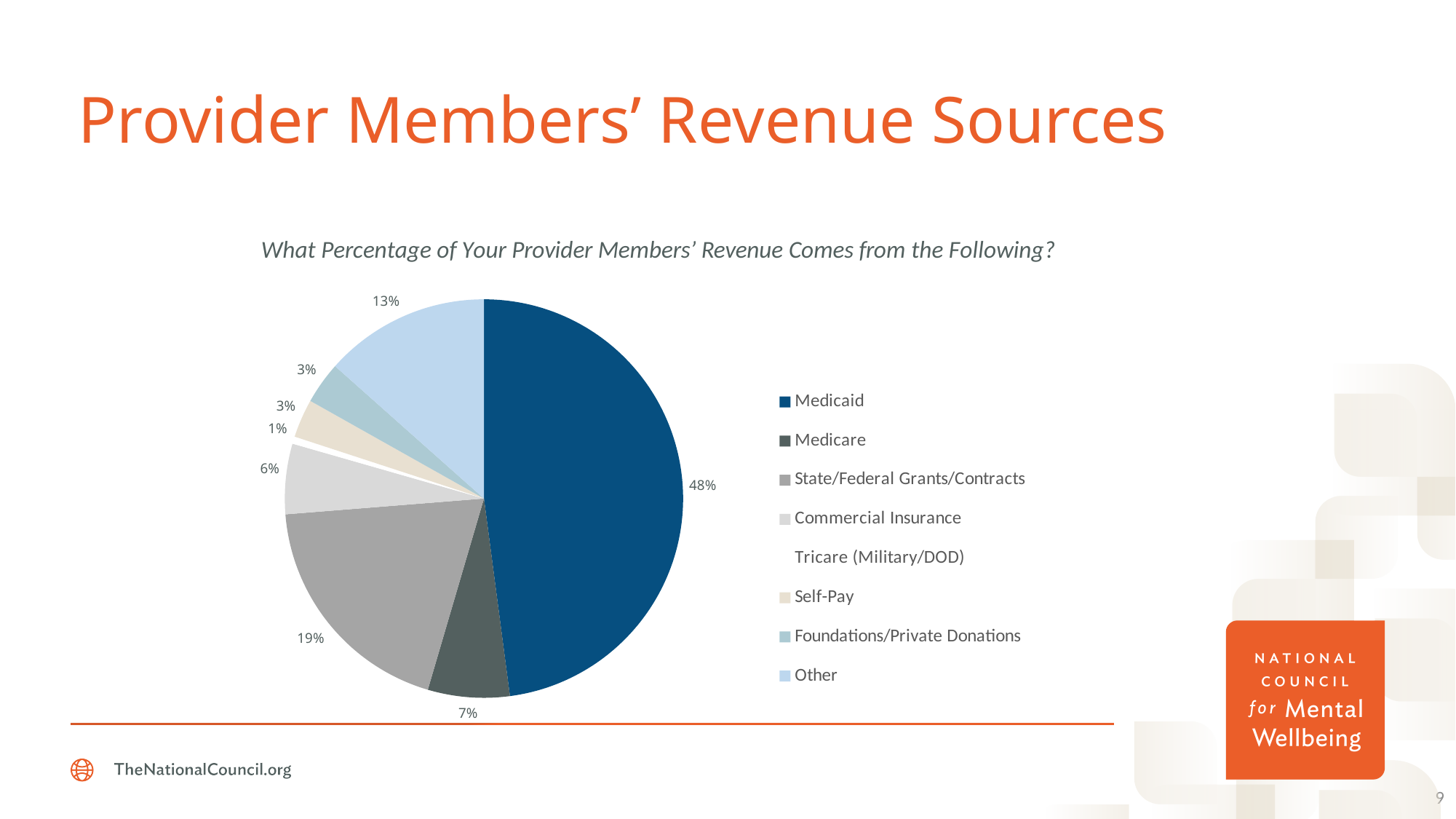
How many revenue sources are shown in the pie chart? 8 What type of chart is shown on the slide? Pie chart Which is larger, the share for Other or the share for Medicare? Other What percentage of revenue comes from State/Federal Grants/Contracts? 19% How many percentage points larger is the Medicaid share than the State/Federal Grants/Contracts share? 29 What percentage of revenue comes from Other sources? 13% What percentage of revenue comes from Tricare (Military/DOD)? 1% Which revenue source has the largest share of the pie? Medicaid What percentage of revenue comes from Medicare? 7% Which revenue source has the smallest share of the pie? Tricare (Military/DOD) What percentage of provider members' revenue comes from Medicaid? 48% What percentage of revenue comes from Commercial Insurance? 6%